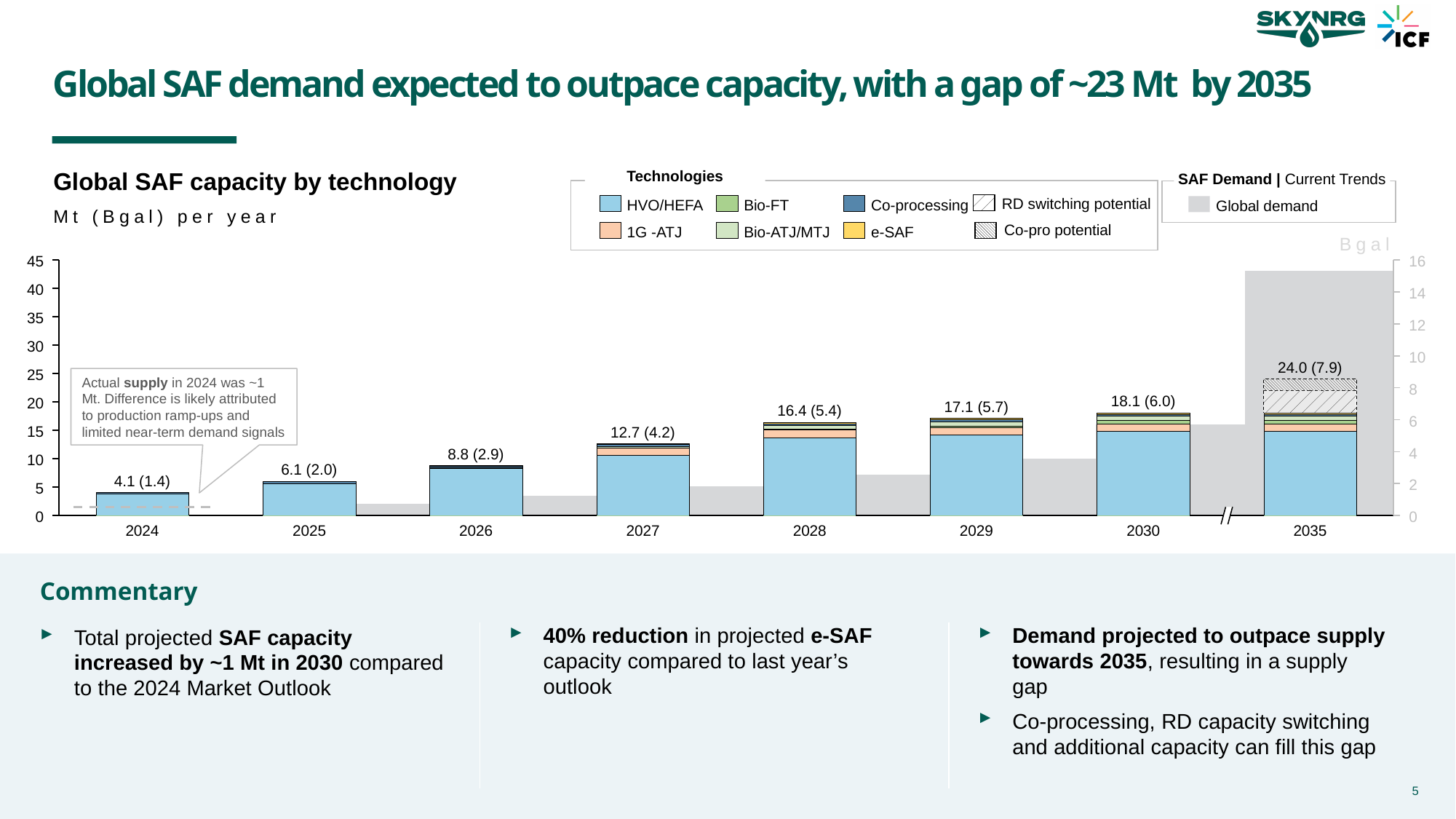
Does the labelled SAF capacity rise or fall from 2024 to 2035? Rises By how many Mt does the labelled SAF capacity in 2030 exceed that in 2024? 14.0 Mt What kind of chart is used to show global SAF capacity by technology? Stacked bar chart What is the total SAF capacity shown for 2030? 18.1 (6.0) How many years are shown on the x axis of the chart? 8 What is the total SAF capacity shown for 2024? 4.1 (1.4) Which year has the larger labelled SAF capacity, 2027 or 2028? 2028 What is the difference in Mt between the labelled SAF capacity in 2035 and in 2030? 5.9 Mt Which year has the highest labelled SAF capacity? 2035 What is the total SAF capacity shown for 2035? 24.0 (7.9) Is the global demand bar for 2035 greater or less than 40 Mt? greater Which year has the lowest labelled SAF capacity? 2024